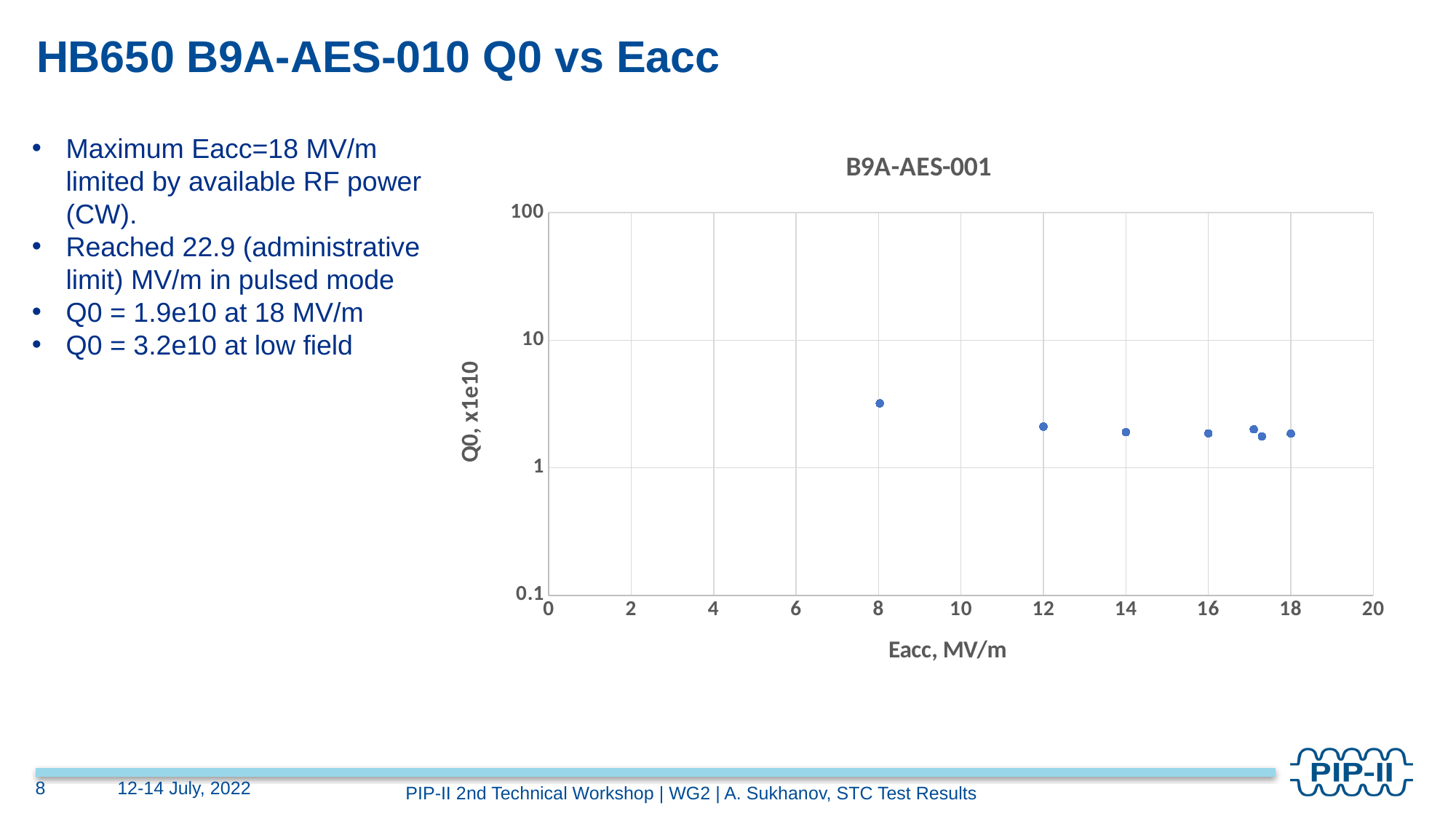
Do the Q0 values generally rise or fall as Eacc increases along the x axis? fall What kind of chart is shown on the slide? scatter chart Is the Q0 value at Eacc = 18 MV/m greater or less than 1? greater At which Eacc value is the plotted Q0 highest? 8 MV/m What is the highest tick value shown on the x axis of the chart? 20 Is the Q0 value at Eacc = 12 MV/m greater or less than 10? less What is the title of the chart? B9A-AES-001 How many data points are plotted on the chart? 7 Which has the larger Q0 value: the point at Eacc = 8 MV/m or the point at Eacc = 18 MV/m? 8 MV/m Is the Q0 value at Eacc = 8 MV/m greater or less than 10? less What is the label of the x axis of the chart? Eacc, MV/m